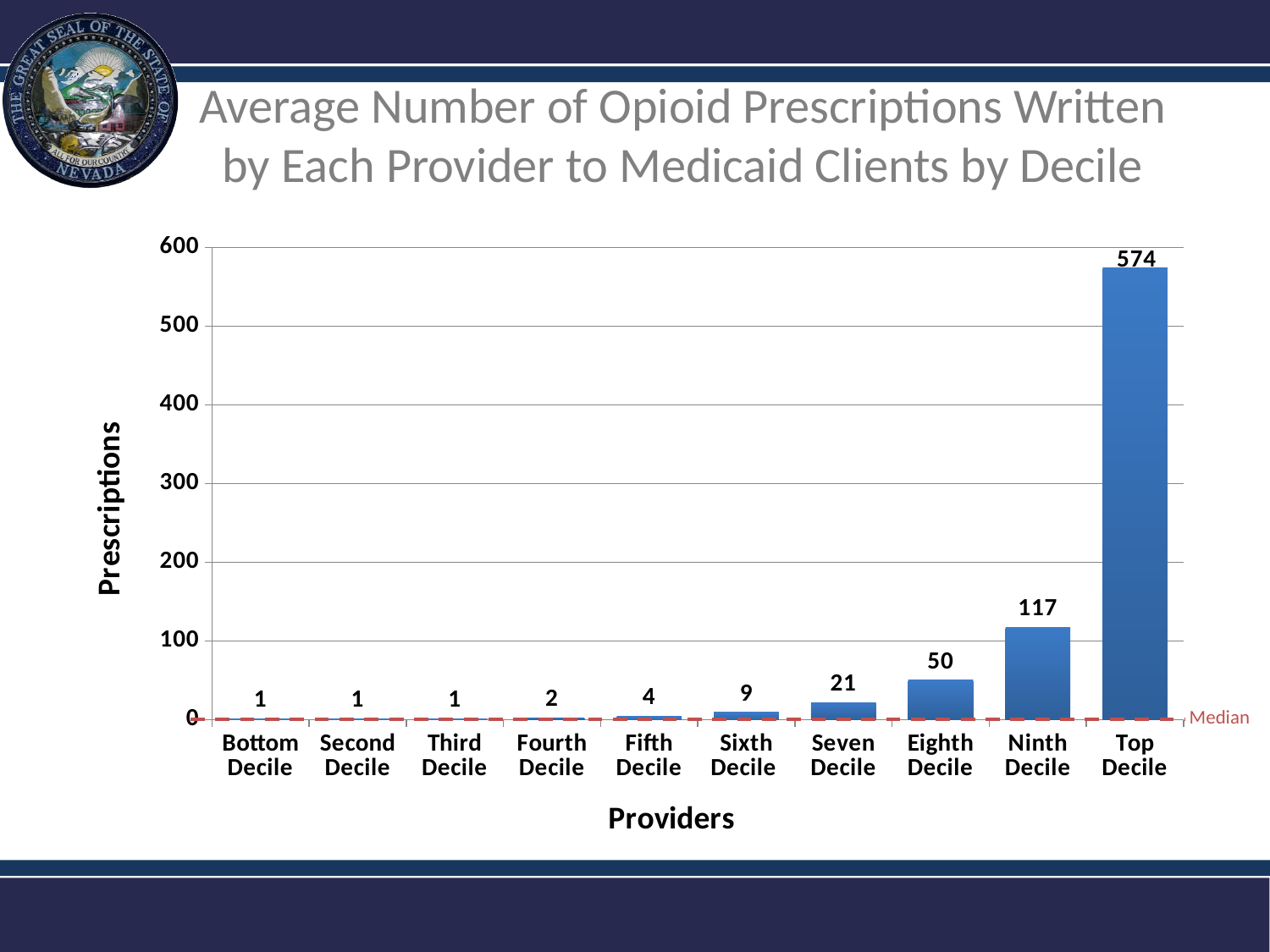
What is the label of the red dashed line on the chart? Median What is the difference between the Top Decile and the Ninth Decile values? 457 Which is larger, the value for the Fifth Decile or the Seven Decile? Seven Decile What kind of chart is shown on the slide? Bar chart What is the average number of opioid prescriptions for the Top Decile? 574 What is the value shown for the Sixth Decile? 9 What is the difference between the Eighth Decile and the Seven Decile values? 29 How many deciles are shown on the x axis? 10 What is the value shown for the Eighth Decile? 50 What is the value shown for the Ninth Decile? 117 Is the value for the Top Decile greater or less than 500? greater Which decile has the highest average number of prescriptions? Top Decile